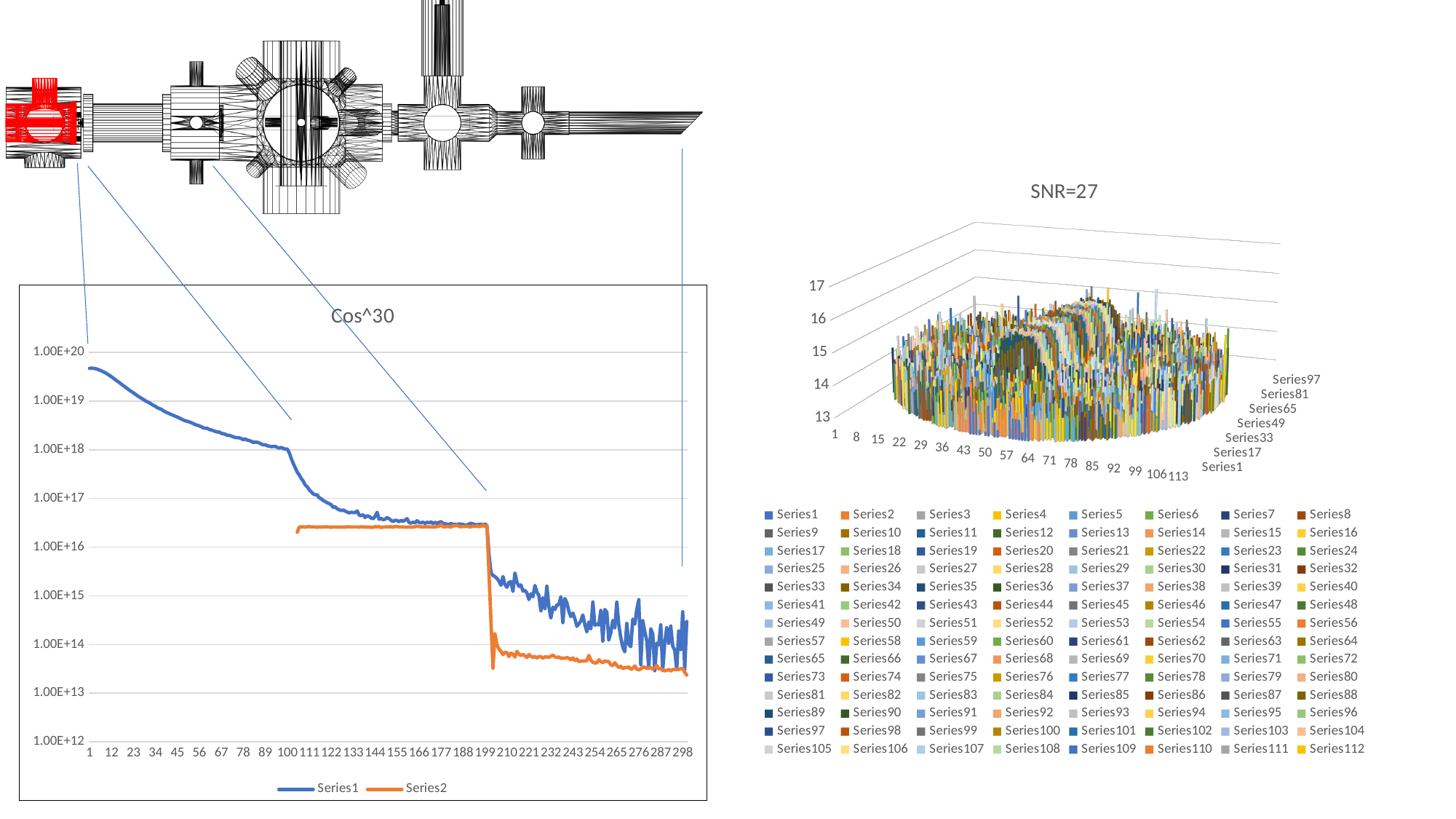
How many series does the legend of the "SNR=27" chart list? 112 In the "Cos^30" chart, which series is drawn in orange? Series2 In the "Cos^30" chart, is the value of Series1 at x = 100 greater or less than 1.00E+17? greater In the "Cos^30" chart, which series has the higher value at x = 254, Series1 or Series2? Series1 What kind of chart is the chart titled "SNR=27"? 3D bar chart In the "Cos^30" chart, does Series1 generally rise or fall as the x axis increases? fall In the "Cos^30" chart, is the value of Series2 at x = 298 greater or less than 1.00E+14? less In the "Cos^30" chart, is the value of Series1 at x = 1 greater or less than 1.00E+19? greater What kind of chart is the chart titled "Cos^30"? line chart How many series does the legend of the "Cos^30" chart list? 2 What is the lowest tick label on the y axis of the "Cos^30" chart? 1.00E+12 What is the title of the chart on the right side of the slide? SNR=27